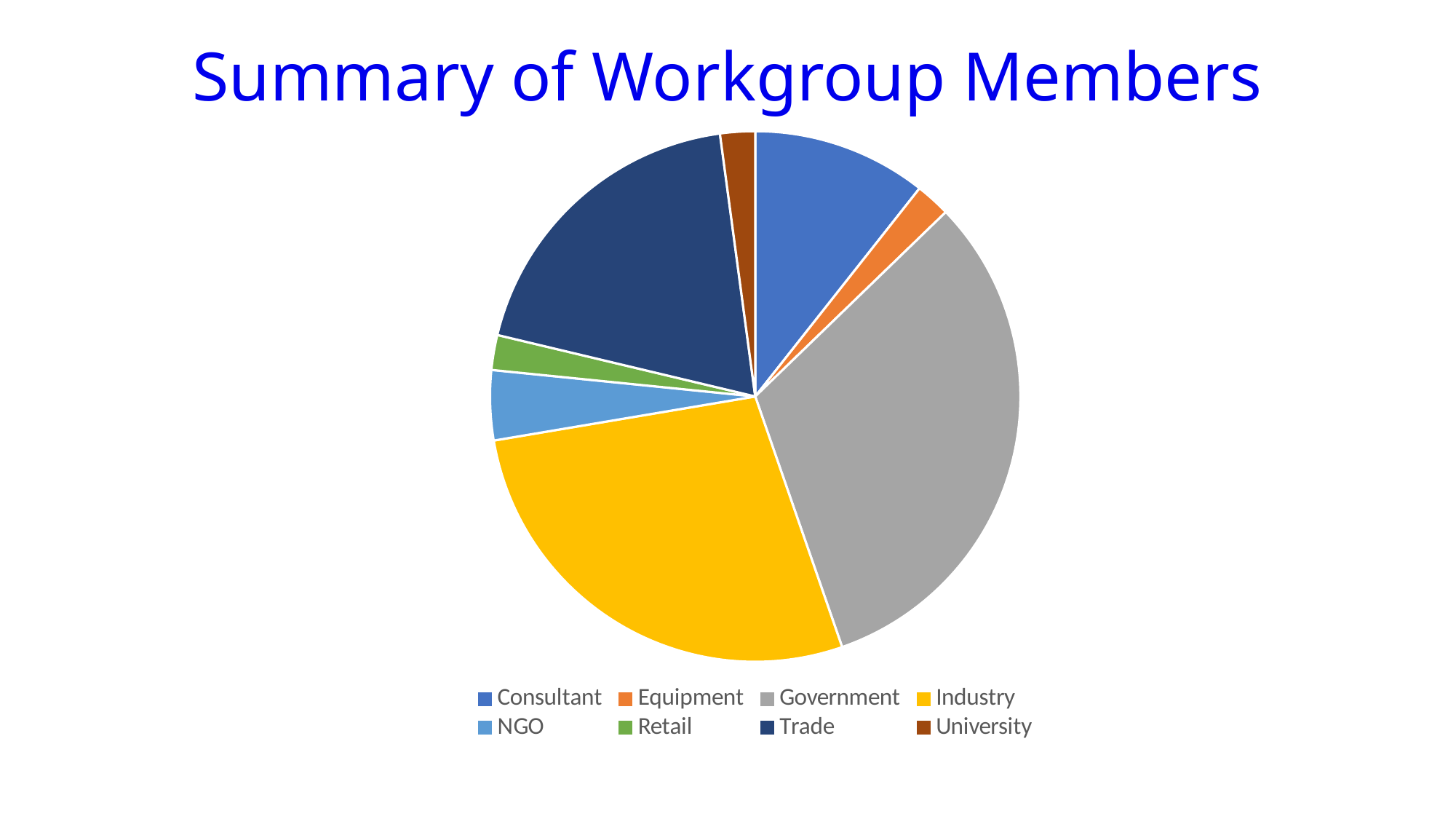
Which slice is larger, NGO or Retail? NGO What kind of chart is shown on the slide? pie chart What colour is the Industry slice? yellow What is the title of the chart? Summary of Workgroup Members Which category is shown in grey? Government Which slice is larger, Consultant or NGO? Consultant Which slice is larger, Government or Industry? Government Which category has the largest slice of the pie? Government How many categories does the pie chart have? 8